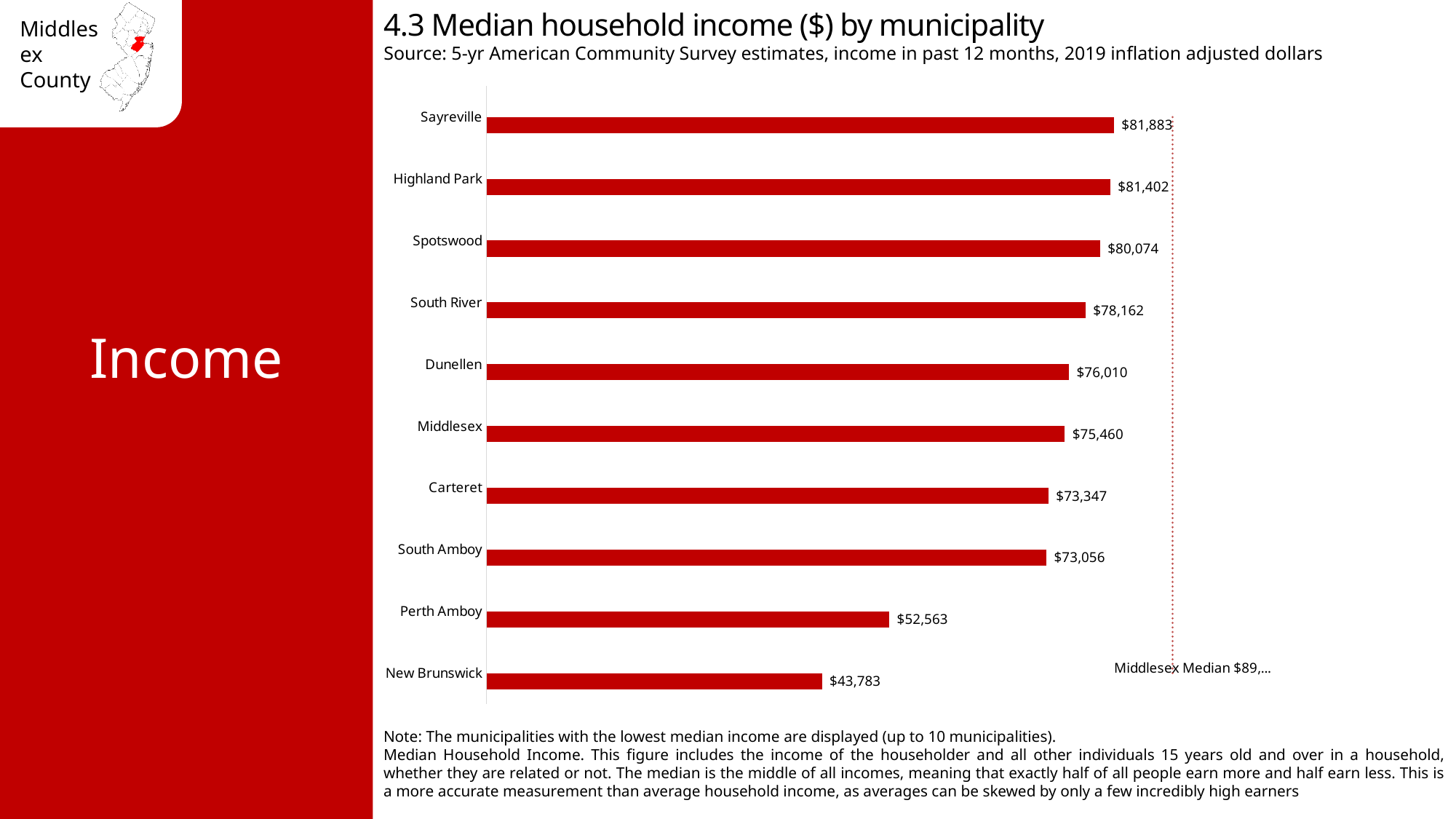
Which municipality has the lowest median household income on the chart? New Brunswick What is the difference between the median household income of Sayreville and New Brunswick? $38,100 Which municipality has the highest median household income on the chart? Sayreville What is the median household income for Perth Amboy? $52,563 What is the title of the chart? 4.3 Median household income ($) by municipality How many municipalities are shown on the chart? 10 What is the difference between the median household income of Perth Amboy and New Brunswick? $8,780 What is the median household income for Sayreville? $81,883 What is the median household income for New Brunswick? $43,783 What type of chart is used on this slide? Bar chart Which has a higher median household income, South River or Carteret? South River What is the median household income for Dunellen? $76,010